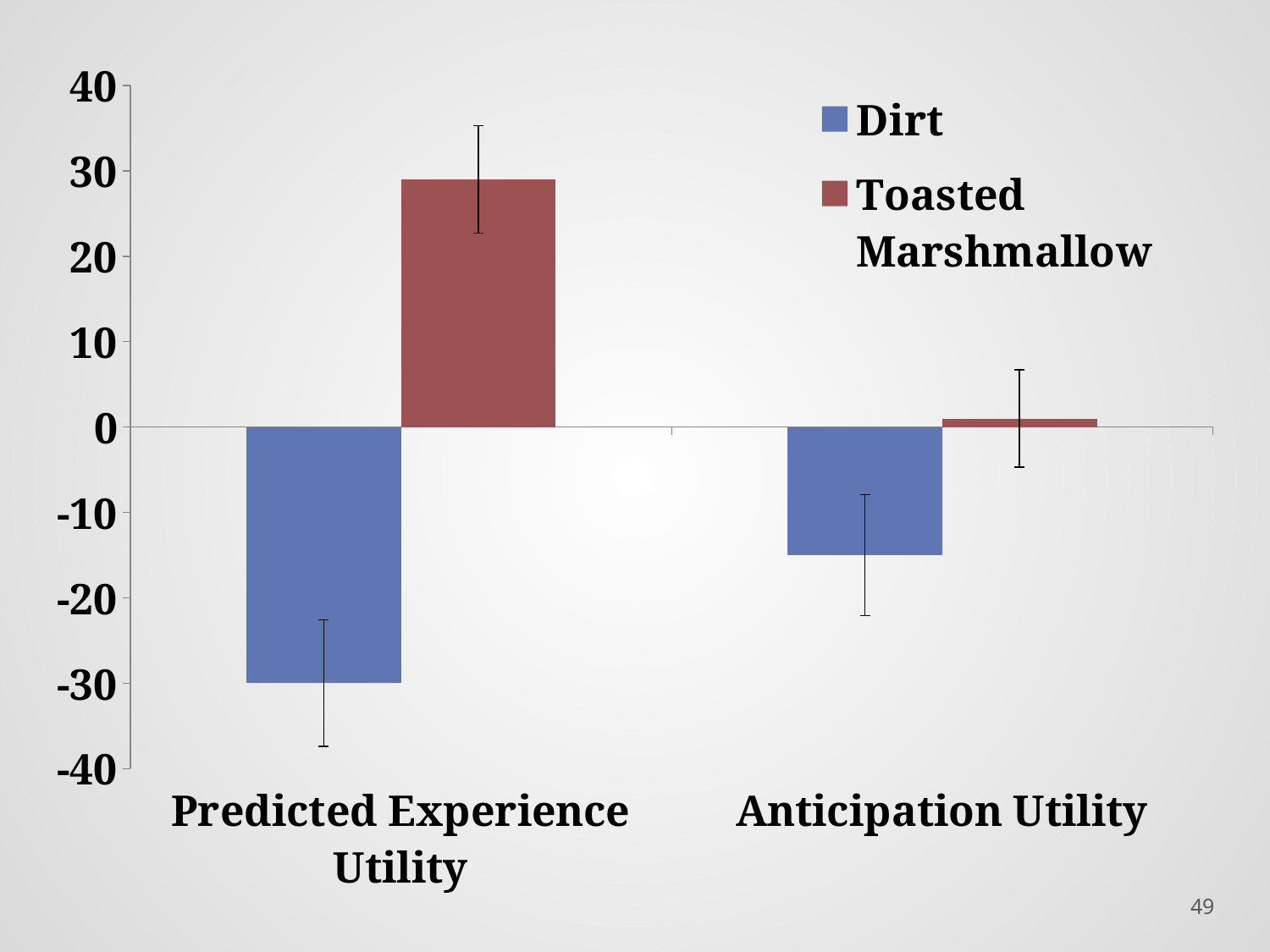
Which series and category has the highest bar? Toasted Marshmallow, Predicted Experience Utility What kind of chart is shown on the slide? bar chart How many series does the legend list? 2 Is the value for Toasted Marshmallow in Anticipation Utility greater or less than 10? less Is the value for Dirt in Predicted Experience Utility greater or less than -20? less How many categories are shown on the x axis? 2 In Anticipation Utility, which series has the larger value, Dirt or Toasted Marshmallow? Toasted Marshmallow Which series and category has the lowest bar? Dirt, Predicted Experience Utility Is the value for Toasted Marshmallow in Predicted Experience Utility greater or less than 20? greater For the Dirt series, which category has the larger value, Predicted Experience Utility or Anticipation Utility? Anticipation Utility What colour represents the Dirt series in the legend? blue